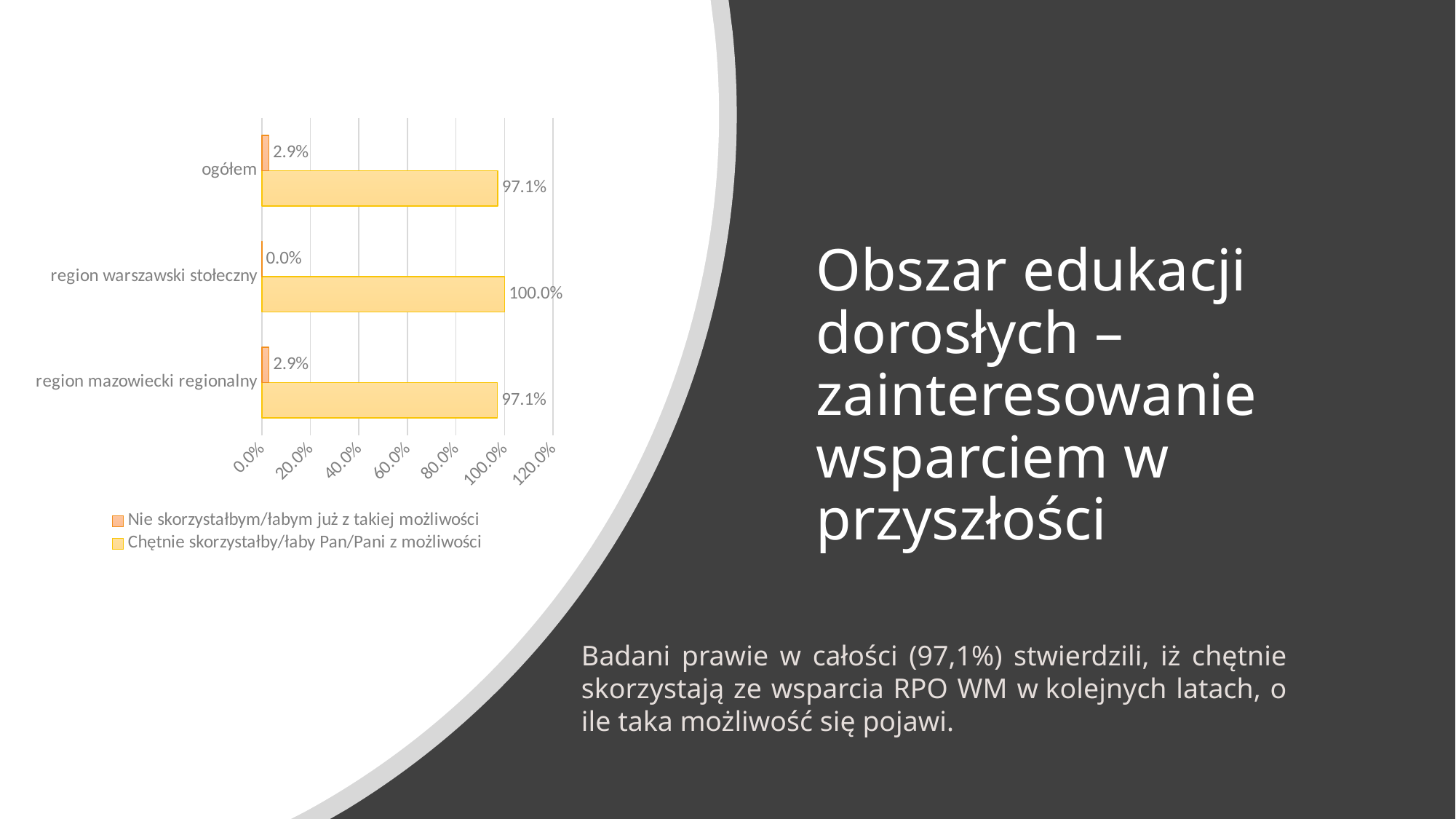
What is the value of "Nie skorzystałbym/łabym już z takiej możliwości" for region warszawski stołeczny? 0.0% Is the "Chętnie skorzystałby/łaby Pan/Pani z możliwości" value for region mazowiecki regionalny greater or less than 80.0%? greater Which category has the lowest value for "Nie skorzystałbym/łabym już z takiej możliwości"? region warszawski stołeczny What is the value of "Nie skorzystałbym/łabym już z takiej możliwości" for ogółem? 2.9% Which is larger for ogółem: "Chętnie skorzystałby/łaby Pan/Pani z możliwości" or "Nie skorzystałbym/łabym już z takiej możliwości"? Chętnie skorzystałby/łaby Pan/Pani z możliwości What is the value of "Chętnie skorzystałby/łaby Pan/Pani z możliwości" for region warszawski stołeczny? 100.0% Which category has the highest value for "Chętnie skorzystałby/łaby Pan/Pani z możliwości"? region warszawski stołeczny What is the difference between the "Chętnie skorzystałby/łaby Pan/Pani z możliwości" value for region warszawski stołeczny and for ogółem? 2.9% How many series does the legend list? 2 What kind of chart is shown on the slide? bar chart What is the value of "Chętnie skorzystałby/łaby Pan/Pani z możliwości" for region mazowiecki regionalny? 97.1% How many categories are shown on the chart? 3